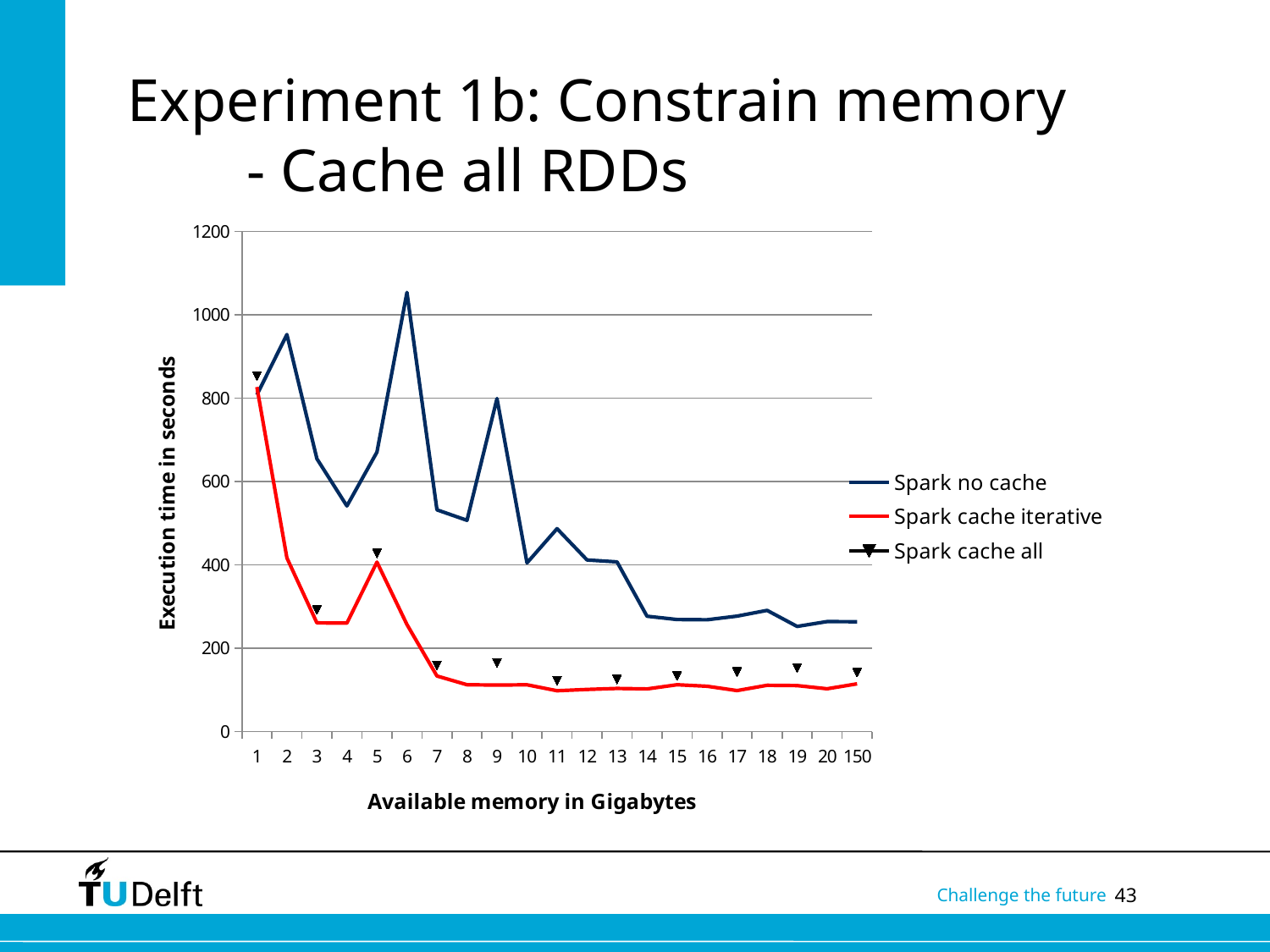
How many memory values are shown along the x axis? 21 At which available memory value does Spark no cache reach its highest execution time? 6 What is the label of the x axis? Available memory in Gigabytes How many series does the legend list? 3 What is the label of the y axis? Execution time in seconds Is the Spark cache iterative value at 3 gigabytes greater or less than 400? less Is the Spark no cache value at 150 gigabytes greater or less than 400? less Does the Spark cache iterative execution time rise or fall from 1 to 7 gigabytes? fall Is the Spark cache all value at 9 gigabytes greater or less than 200? less At 5 gigabytes, which series has the larger execution time: Spark no cache or Spark cache iterative? Spark no cache What kind of chart is shown on the slide? line chart